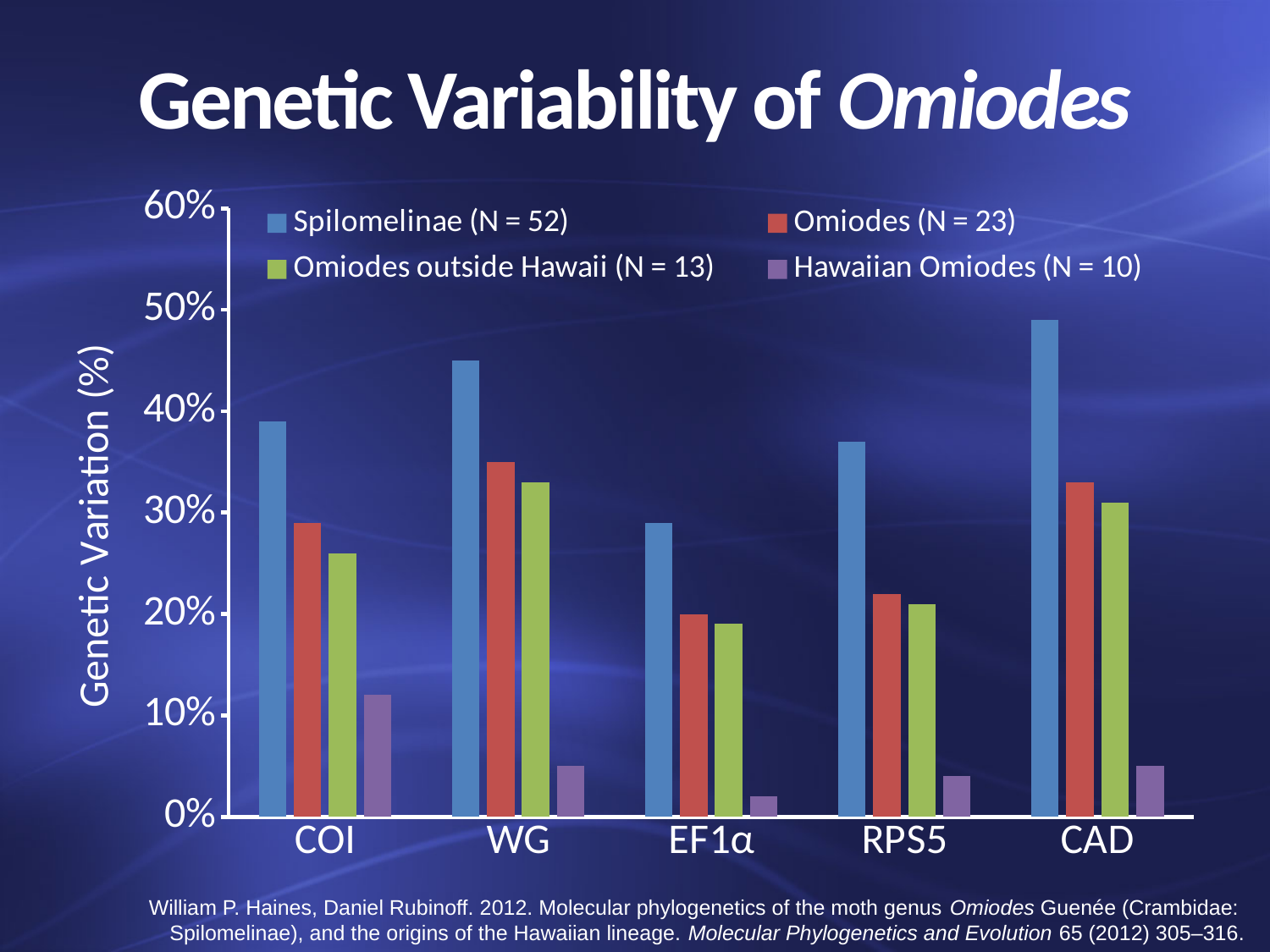
For which gene is the Hawaiian Omiodes (N = 10) value highest? COI Which is larger for Omiodes outside Hawaii (N = 13): the value for COI or the value for RPS5? COI Which is larger for Spilomelinae (N = 52): the value for CAD or the value for WG? CAD How many series does the legend list? 4 How many gene categories are shown on the x axis? 5 Is the Spilomelinae (N = 52) value for WG greater or less than 40%? greater What kind of chart is shown on the slide? bar chart What is the label of the y axis? Genetic Variation (%) Is the Hawaiian Omiodes (N = 10) value for EF1α greater or less than 10%? less For which gene is the Spilomelinae (N = 52) value lowest? EF1α Is the Omiodes (N = 23) value for WG greater or less than 30%? greater For which gene is the Spilomelinae (N = 52) value highest? CAD